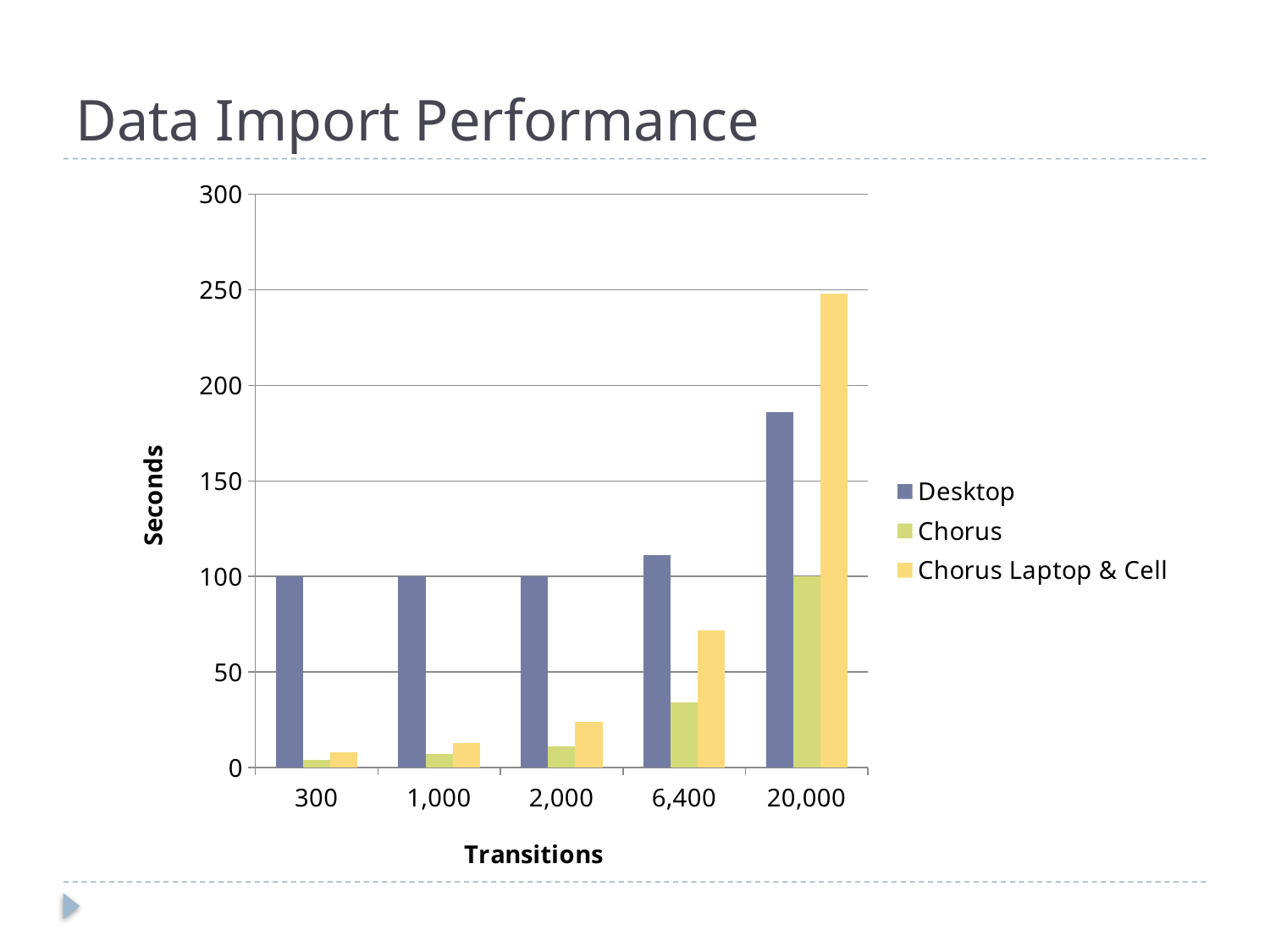
Is the value for Chorus Laptop & Cell at 20,000 transitions greater or less than 200? greater Is the value for Desktop at 20,000 transitions greater or less than 150? greater Do the Chorus Laptop & Cell values rise or fall as the number of transitions increases? rise At 6,400 transitions, which is larger: Desktop or Chorus Laptop & Cell? Desktop Which series has the shortest bar at 300 transitions? Chorus Is the value for Chorus at 6,400 transitions greater or less than 50? less How many transition categories are shown on the x axis? 5 How many series does the legend list? 3 What kind of chart is shown on the slide? bar chart What is the label on the vertical axis? Seconds Which series has the tallest bar at 20,000 transitions? Chorus Laptop & Cell